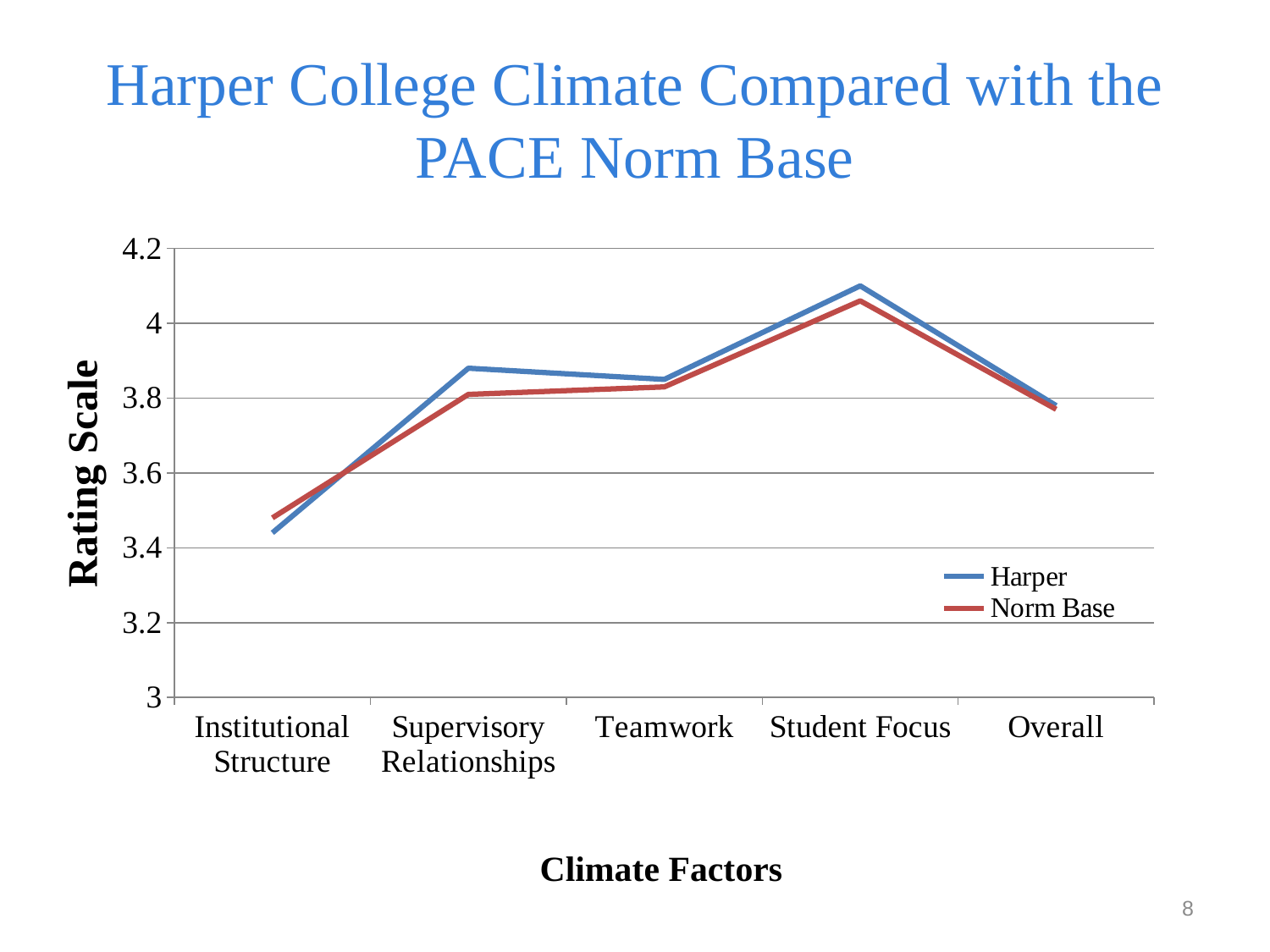
For which climate factor is the Harper rating highest? Student Focus For which climate factor is the Norm Base rating lowest? Institutional Structure Do the Harper values rise or fall from Student Focus to Overall? fall What is the label on the vertical axis? Rating Scale Is the Harper value for Institutional Structure greater or less than 3.6? less What kind of chart is shown on the slide? line chart Is the Harper value for Student Focus greater or less than 4? greater How many climate factors are plotted along the x axis? 5 Is the Norm Base value for Supervisory Relationships greater or less than 3.6? greater How many series does the legend list? 2 Which series has the higher value for Student Focus, Harper or Norm Base? Harper Which series has the higher value for Supervisory Relationships, Harper or Norm Base? Harper